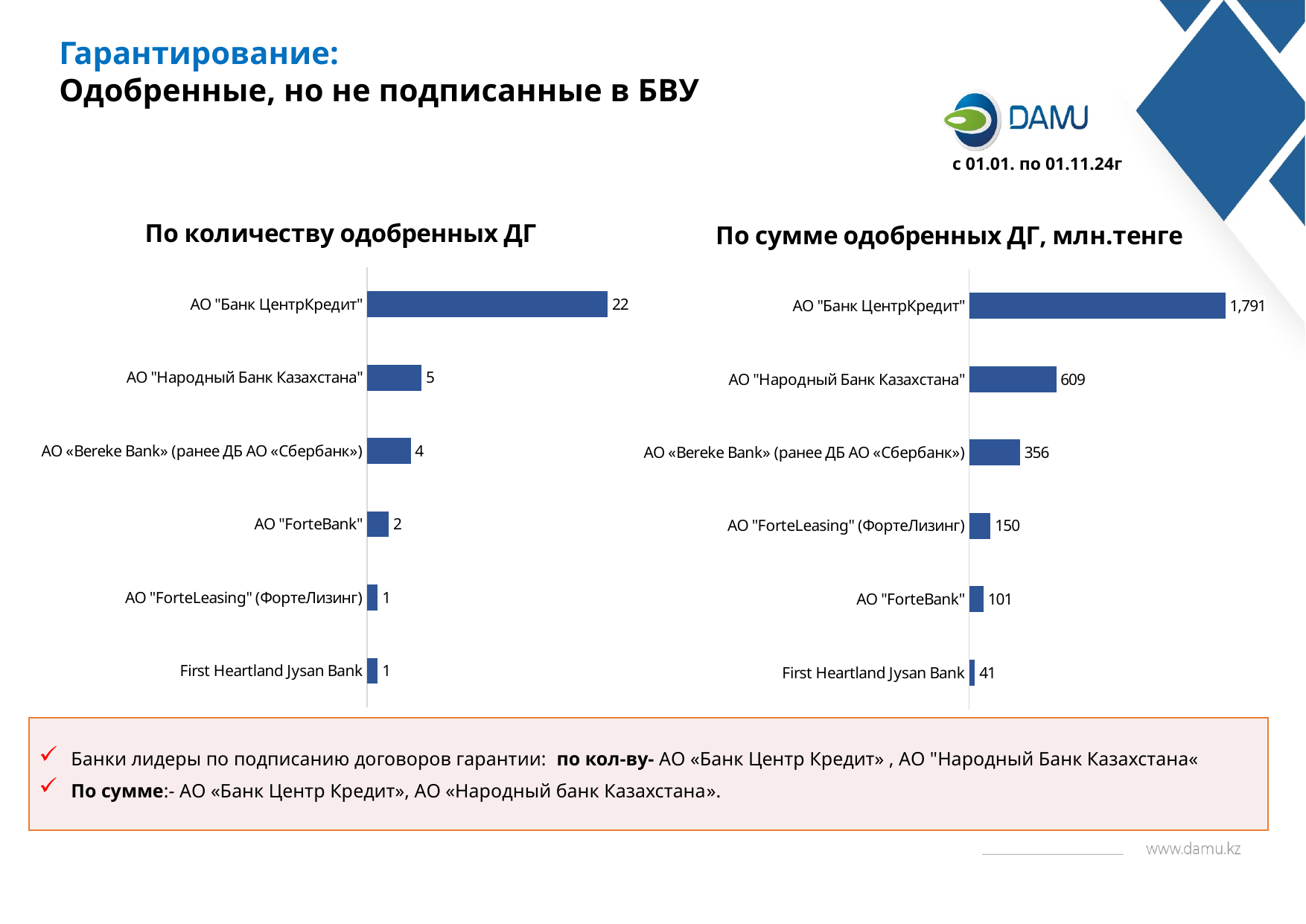
In the chart "По сумме одобренных ДГ, млн.тенге", what is the difference between АО "Народный Банк Казахстана" and АО «Bereke Bank» (ранее ДБ АО «Сбербанк»)? 253 In the chart "По сумме одобренных ДГ, млн.тенге", what is the value for First Heartland Jysan Bank? 41 In the chart "По количеству одобренных ДГ", what is the value for АО "Банк ЦентрКредит"? 22 In the chart "По количеству одобренных ДГ", what is the difference between АО "Банк ЦентрКредит" and АО "Народный Банк Казахстана"? 17 In the chart "По сумме одобренных ДГ, млн.тенге", which is larger: АО "ForteLeasing" (ФортеЛизинг) or АО "ForteBank"? АО "ForteLeasing" (ФортеЛизинг) In the chart "По количеству одобренных ДГ", which bank has the highest value? АО "Банк ЦентрКредит" In the chart "По сумме одобренных ДГ, млн.тенге", which bank has the lowest value? First Heartland Jysan Bank What is the title of the chart on the right side of the slide? По сумме одобренных ДГ, млн.тенге In the chart "По количеству одобренных ДГ", which is larger: АО "ForteBank" or АО «Bereke Bank» (ранее ДБ АО «Сбербанк»)? АО «Bereke Bank» (ранее ДБ АО «Сбербанк») What type of chart is "По количеству одобренных ДГ"? Bar chart How many banks are shown in the chart "По сумме одобренных ДГ, млн.тенге"? 6 In the chart "По сумме одобренных ДГ, млн.тенге", what is the value for АО "Народный Банк Казахстана"? 609